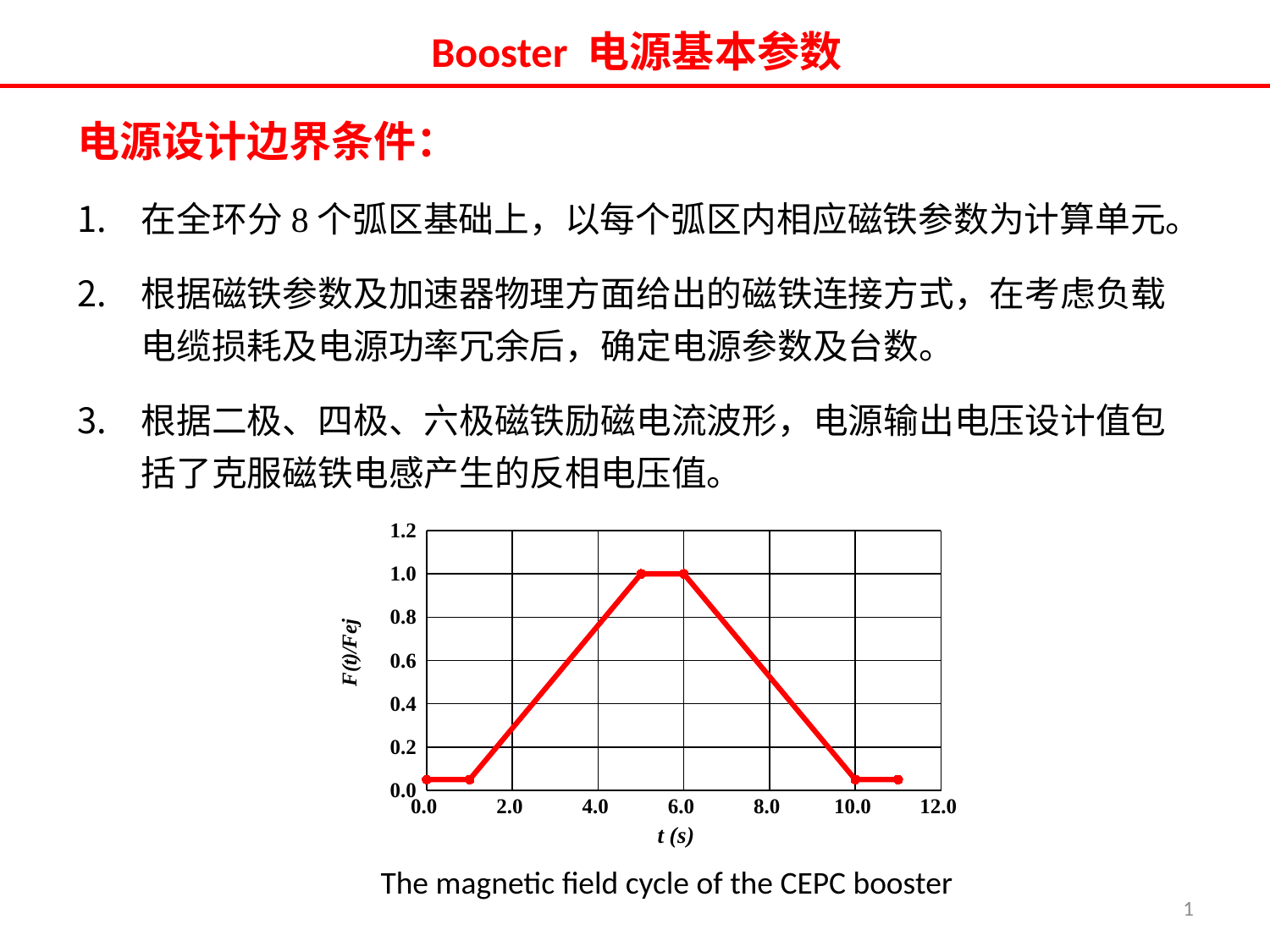
Is the value of F(t)/Fej at t = 2.0 s greater or less than 0.4? less Is the value of F(t)/Fej at t = 8.0 s greater or less than 0.6? less Does F(t)/Fej rise or fall between t = 6.0 s and t = 10.0 s? fall Is the value of F(t)/Fej at t = 10.0 s greater or less than 0.2? less What is the value of F(t)/Fej at t = 6.0 s? 1.0 Does F(t)/Fej rise or fall between t = 1.0 s and t = 5.0 s? rise What kind of chart is shown on the slide? line chart What is the label of the x axis of the chart? t (s) What is the maximum value of F(t)/Fej reached in the chart? 1.0 How many marked data points are on the line? 6